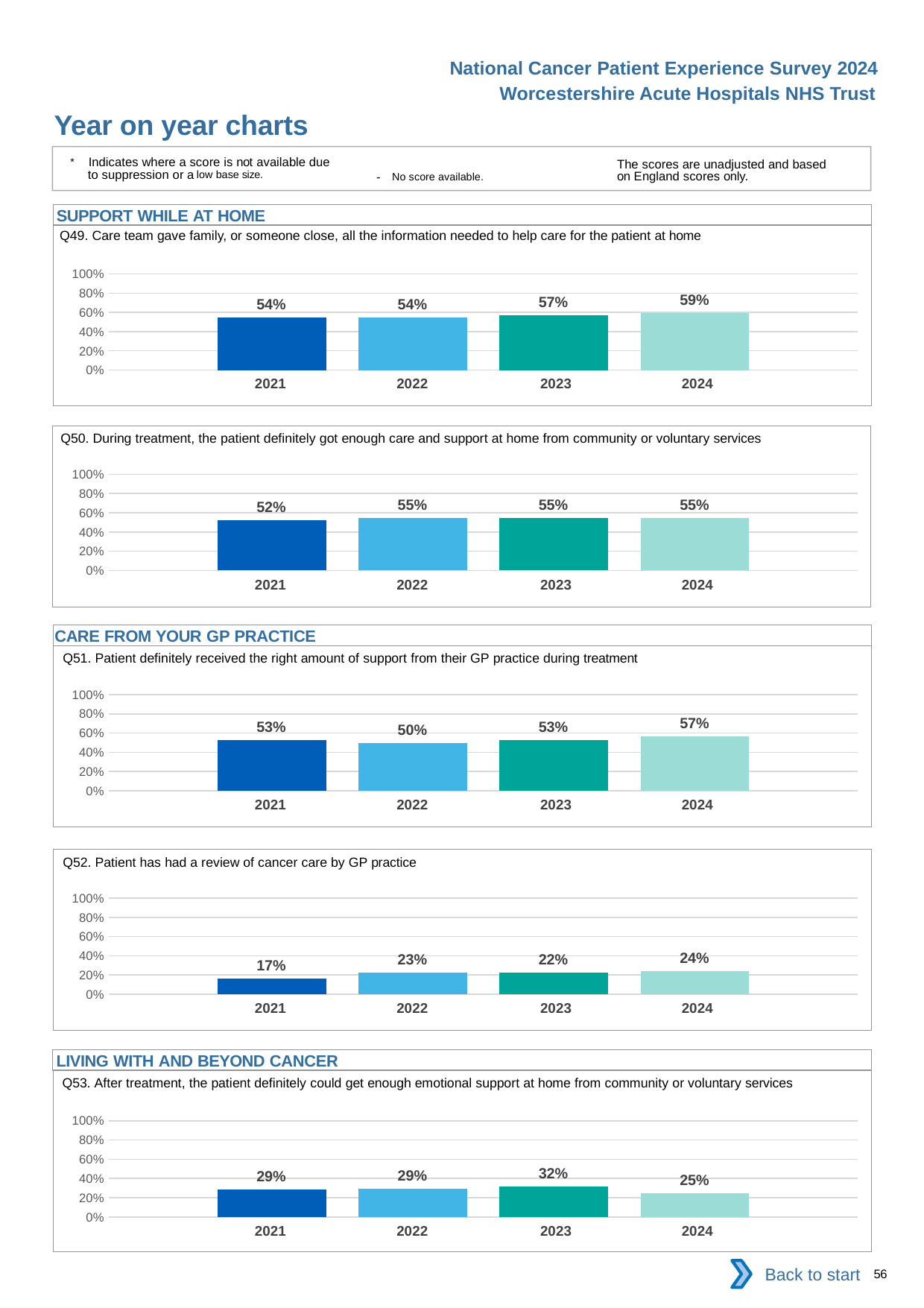
In the Q49 chart, do the values rise or fall from 2021 to 2024? rise In the Q52 chart, is the value for 2024 greater or less than 40%? less In the Q49 chart, what is the value for 2024? 59% In the Q53 chart, which year has the highest value? 2023 In the Q53 chart, is the value for 2024 greater or less than 2023? less In the Q52 chart, what is the value for 2021? 17% What kind of chart is the Q52 chart? bar chart In the Q51 chart, what is the difference between the 2024 and 2022 values? 7% In the Q49 chart, how many years are plotted? 4 In the Q50 chart, which year has the lowest value? 2021 Which section heading appears above the Q53 chart? LIVING WITH AND BEYOND CANCER In the Q51 chart, what is the value for 2022? 50%